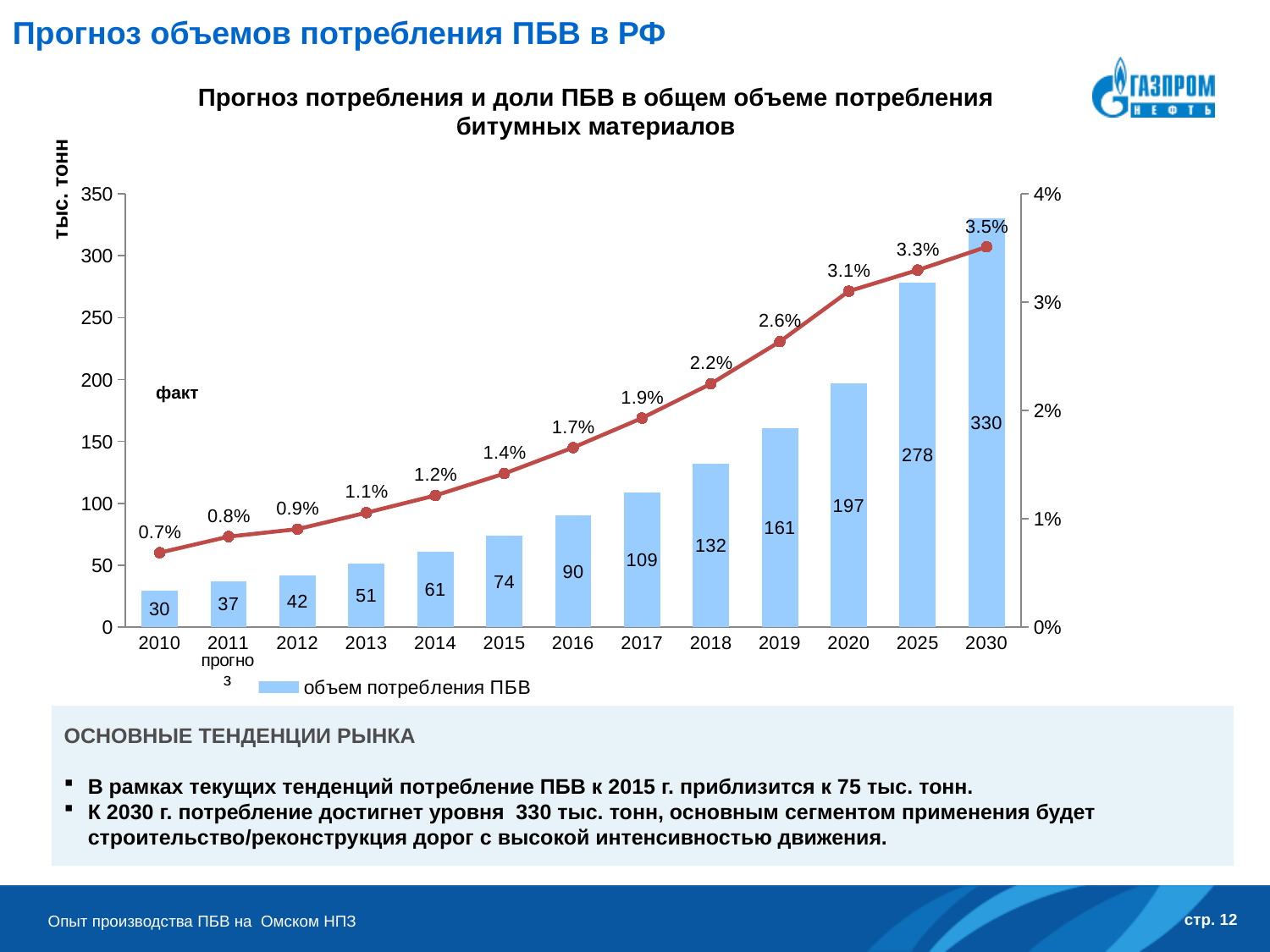
Which year has the highest PBV consumption volume? 2030 Do the consumption volumes rise or fall from 2010 to 2030? rise What is the consumption volume shown for 2025? 278 What is the difference in consumption volume between 2030 and 2020? 133 What is the PBV consumption volume (объем потребления ПБВ) for 2015? 74 Which year has the lowest PBV consumption volume? 2010 What kind of chart is used to show the consumption volume? bar chart How many years are shown on the x axis? 13 What share of total bitumen consumption does the line show for 2019? 2.6% What is the share value shown for 2010? 0.7% Which year has the larger consumption volume, 2017 or 2018? 2018 What is the unit label on the left vertical axis? тыс. тонн